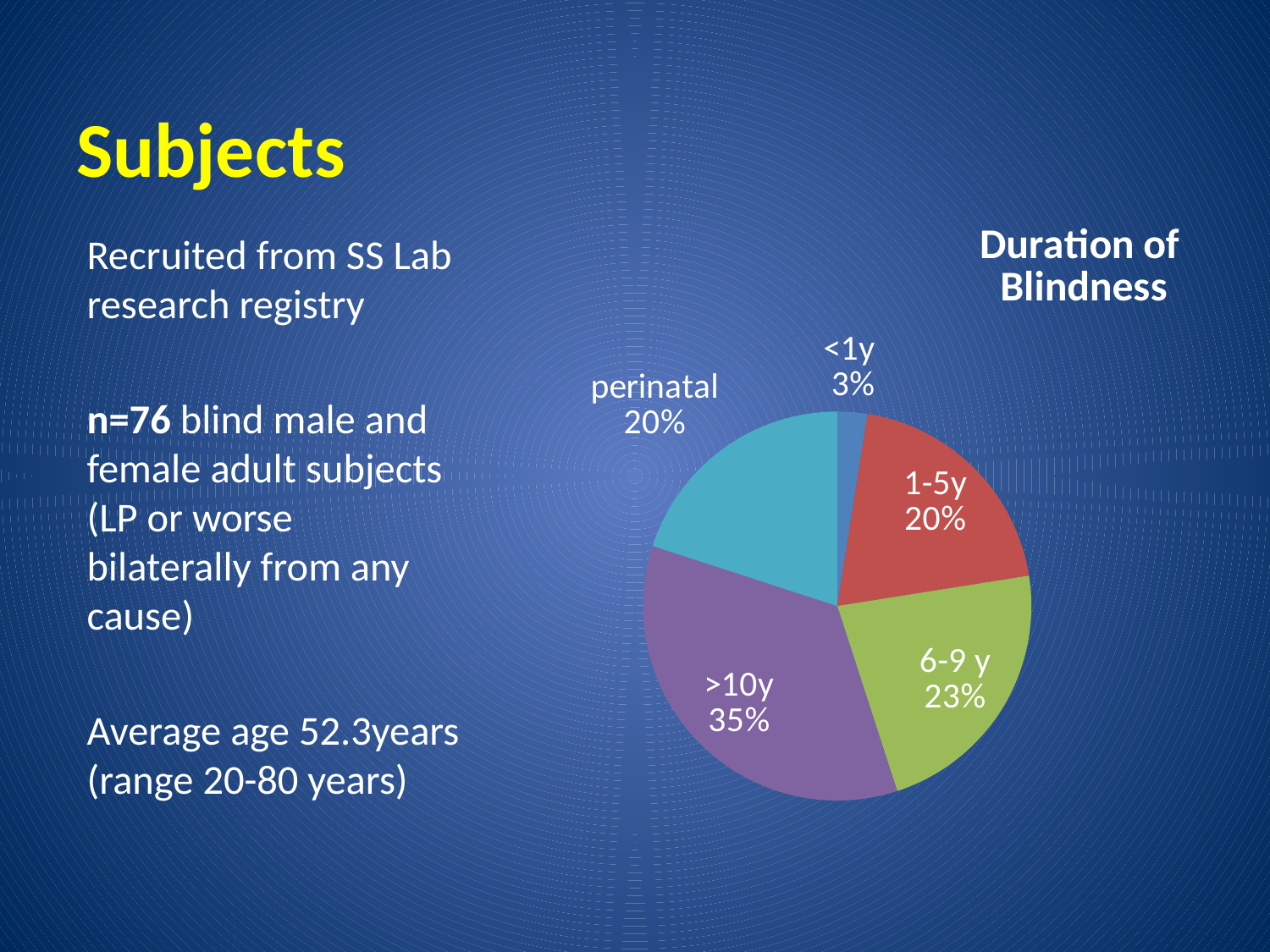
What percentage is shown for the <1y slice? 3% Which is larger, the 1-5y slice or the 6-9 y slice? 6-9 y What colour is the >10y slice? purple What is the title of the chart? Duration of Blindness What share of the pie does the >10y slice represent? 35% What share of the pie does the 6-9 y slice represent? 23% What is the difference in percentage points between the >10y slice and the 6-9 y slice? 12 Which duration category has the largest share of the pie? >10y What kind of chart is shown on the slide? pie chart How many slices does the pie chart have? 5 Which duration category has the smallest share of the pie? <1y What percentage is shown for the perinatal slice? 20%